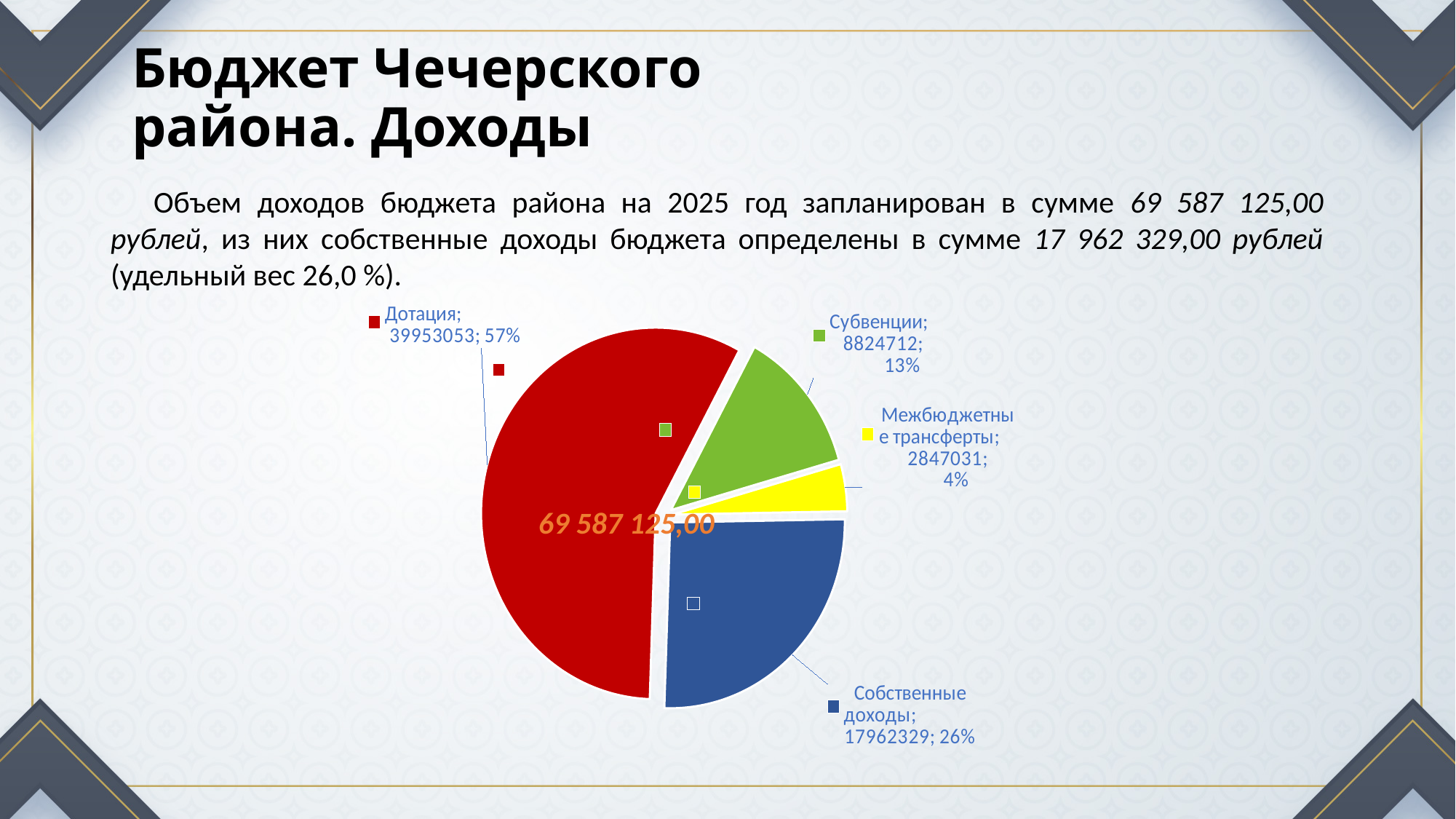
What share of the pie does Собственные доходы represent? 26% Which category has the largest slice of the pie? Дотация What is the value shown for Межбюджетные трансферты? 2847031 What is the value shown for Собственные доходы? 17962329 What total value is printed in the centre of the pie chart? 69 587 125,00 What kind of chart is shown on the slide? pie chart Which is larger, Субвенции or Собственные доходы? Собственные доходы What share of the pie does Дотация represent? 57% Which category has the smallest slice of the pie? Межбюджетные трансферты What is the value shown for Субвенции? 8824712 How many slices does the pie chart have? 4 What is the value shown for Дотация? 39953053